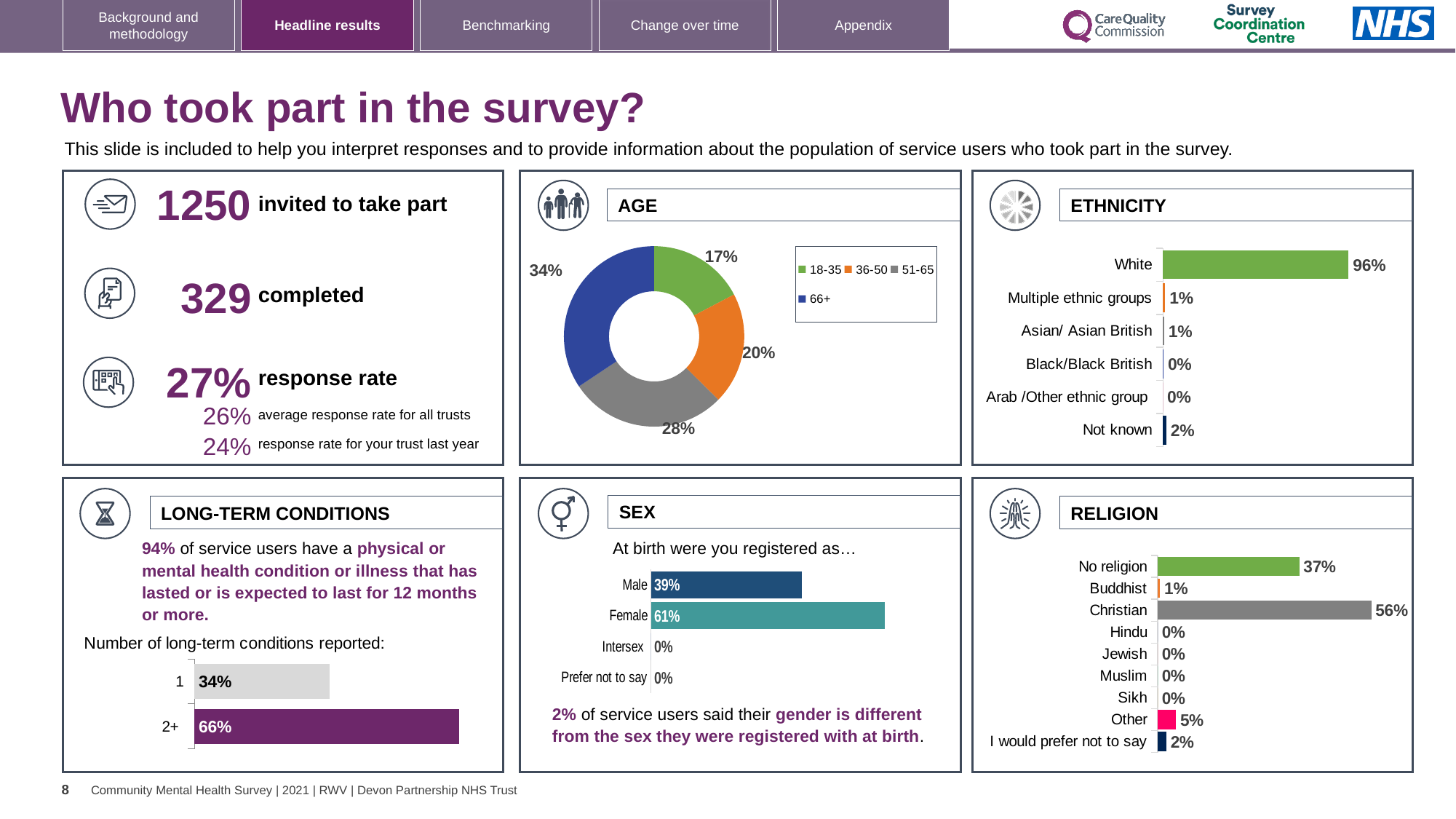
In the AGE chart, which age group has the smallest share? 18-35 In the AGE chart, what share of respondents were aged 66+? 34% How many categories are shown in the RELIGION chart? 9 In the RELIGION chart, which religion category has the highest value? Christian In the LONG-TERM CONDITIONS chart, what percentage of service users reported 2+ long-term conditions? 66% What kind of chart is the AGE chart? Donut chart How many ethnicity categories are shown in the ETHNICITY chart? 6 In the SEX chart, which is larger, Male or Female? Female In the ETHNICITY chart, what is the difference between White and Not known? 94% How many age groups does the legend of the AGE chart list? 4 In the SEX chart, what is the difference between Female and Male? 22% In the ETHNICITY chart, what is the value for White? 96%